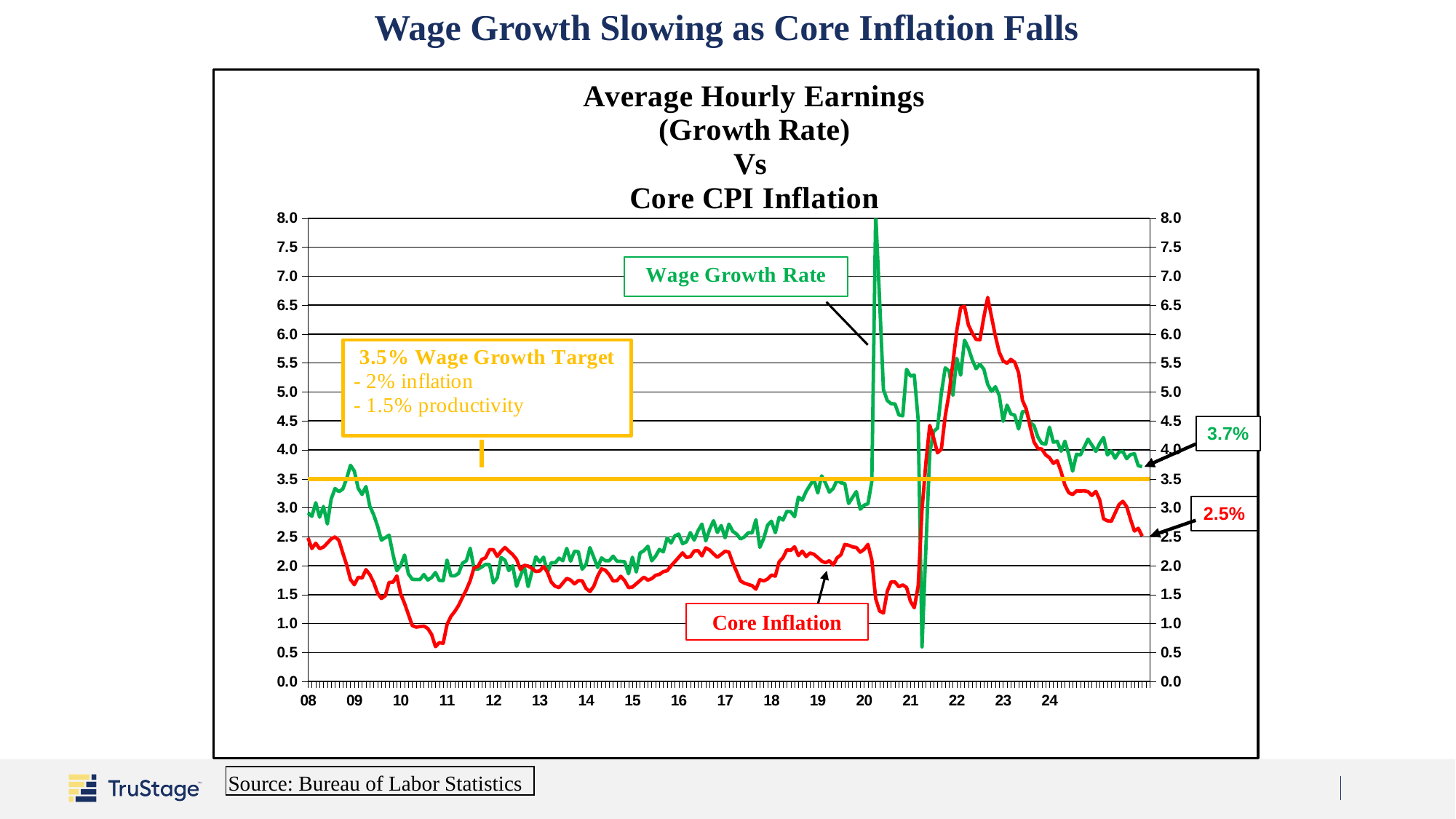
At the end of the chart, which series is higher: Wage Growth Rate or Core Inflation? Wage Growth Rate What is the source of the data cited on the slide? Bureau of Labor Statistics Is the latest Wage Growth Rate value greater or less than the 3.5% wage growth target line? greater From its peak around 2022 to the end of the chart, does Core Inflation rise or fall? Fall What type of chart is shown on the slide? Line chart Is the latest Core Inflation value greater or less than 3.0? less What is the most recent value labeled for Core Inflation? 2.5% Which series reaches the highest peak on the chart? Wage Growth Rate What is the most recent value labeled for the Wage Growth Rate? 3.7% What is the difference between the latest labeled Wage Growth Rate (3.7%) and the latest labeled Core Inflation (2.5%)? 1.2% Is the peak of the Wage Growth Rate spike around 2020 greater or less than 7.0? greater What wage growth target is marked by the horizontal yellow line? 3.5%